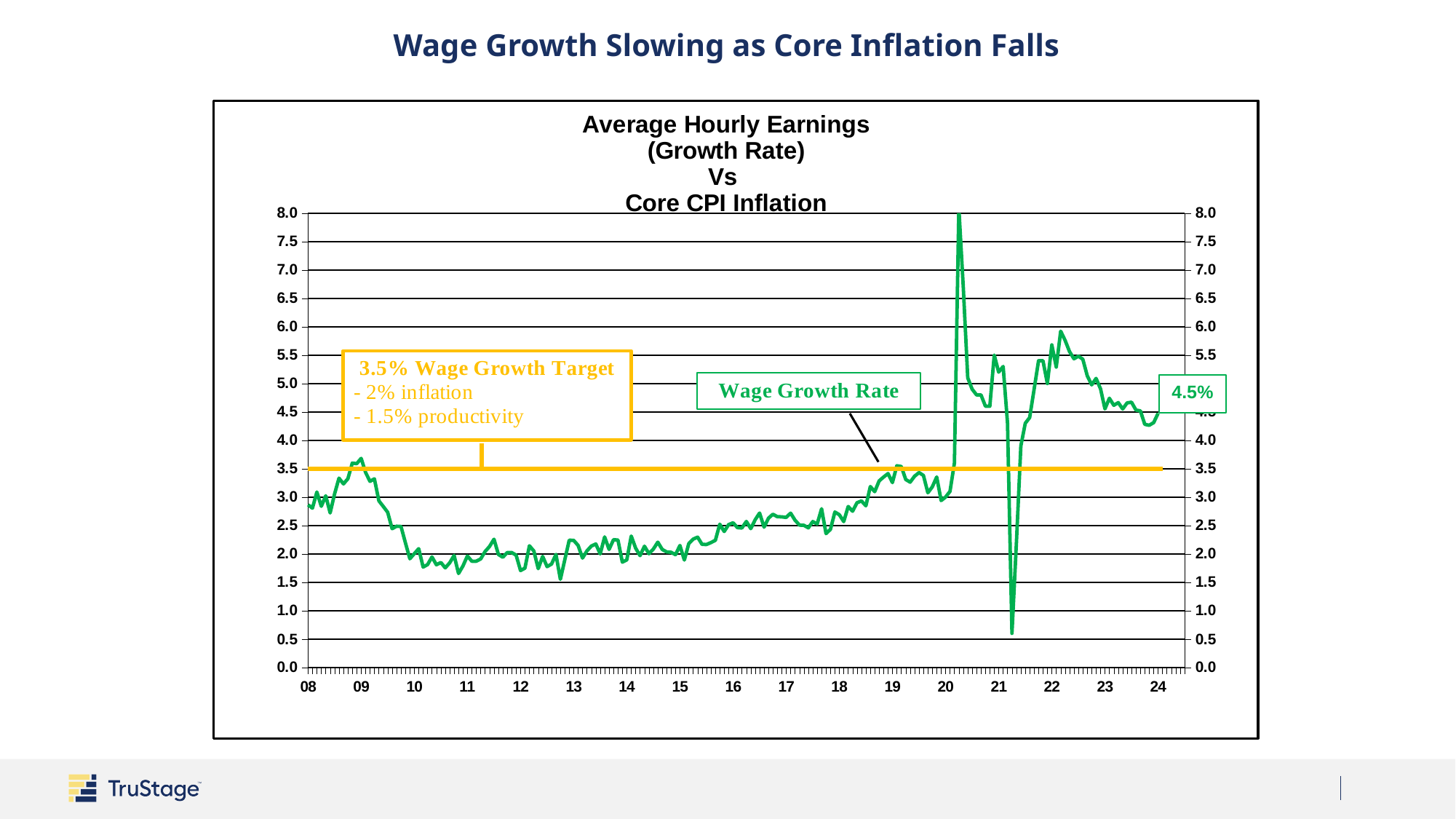
Is the Wage Growth Rate in 2012 greater or less than 2.5? less Is the peak of the Wage Growth Rate in 2020 greater or less than 7.0? greater Is the latest Wage Growth Rate value larger or smaller than the 3.5% Wage Growth Target? larger What is the Wage Growth Target shown by the horizontal yellow line? 3.5% How many year labels are shown on the x axis? 17 What two components make up the 3.5% Wage Growth Target according to the annotation box? 2% inflation and 1.5% productivity What kind of chart is shown on the slide? line chart Is the lowest point of the Wage Growth Rate around 2021 greater or less than 1.0? less From 2010 to 2019, does the Wage Growth Rate generally rise or fall? rise From 2022 to 2024, does the Wage Growth Rate generally rise or fall? fall What is the most recent value of the Wage Growth Rate labeled on the chart? 4.5% By how much does the latest Wage Growth Rate (4.5%) exceed the 3.5% Wage Growth Target? 1.0 percentage points